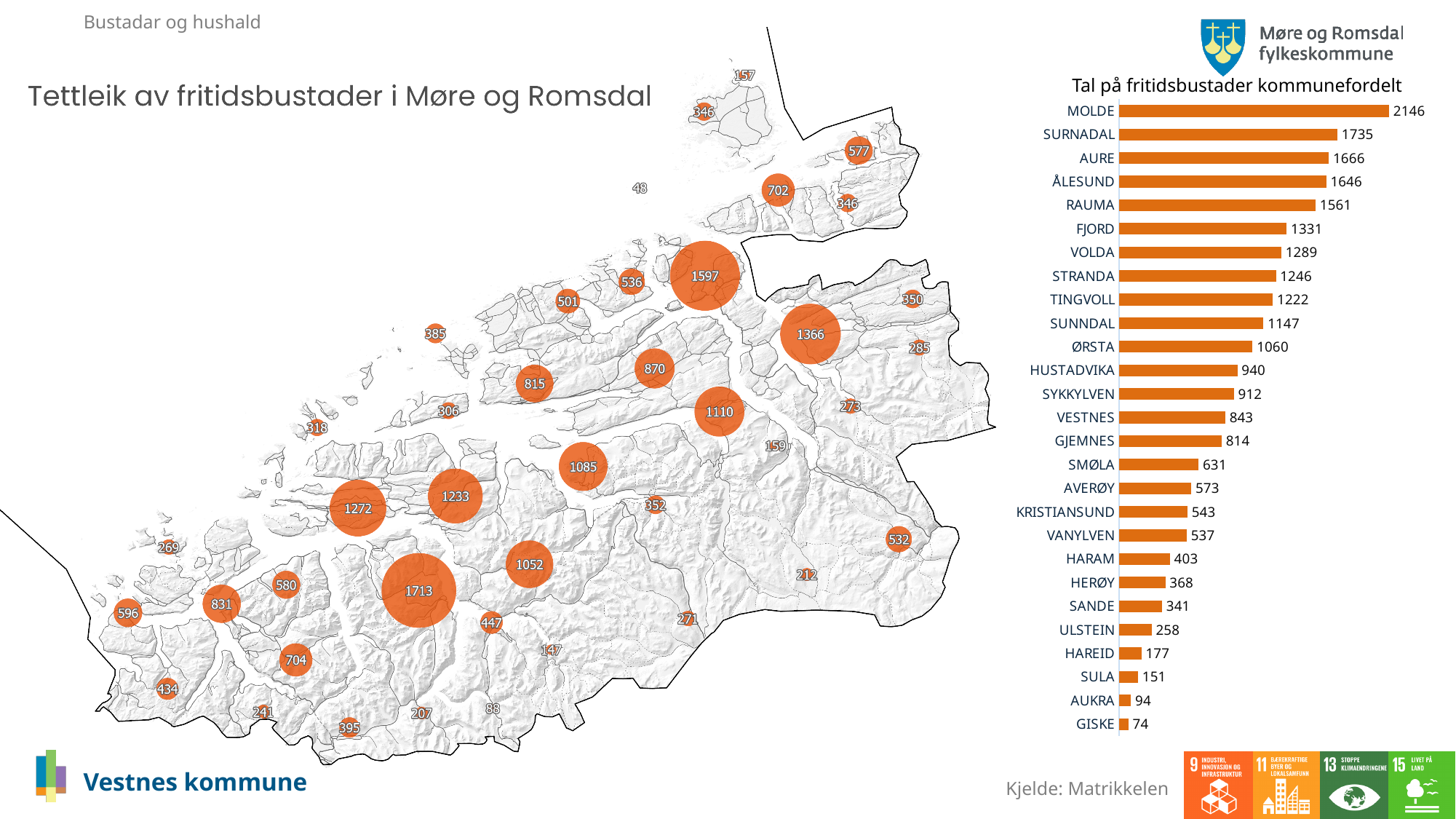
In the bar chart 'Tal på fritidsbustader kommunefordelt', what is the value for HAREID? 177 How many municipalities are listed in the bar chart 'Tal på fritidsbustader kommunefordelt'? 27 In the bar chart 'Tal på fritidsbustader kommunefordelt', which is larger, the value for VOLDA or the value for STRANDA? VOLDA In the bar chart 'Tal på fritidsbustader kommunefordelt', which is larger, the value for SMØLA or the value for HARAM? SMØLA What kind of chart is 'Tal på fritidsbustader kommunefordelt'? Bar chart In the bar chart 'Tal på fritidsbustader kommunefordelt', what is the value for RAUMA? 1561 In the bar chart 'Tal på fritidsbustader kommunefordelt', which municipality has the highest value? MOLDE In the bar chart 'Tal på fritidsbustader kommunefordelt', what is the difference between the values for MOLDE and SURNADAL? 411 In the bar chart 'Tal på fritidsbustader kommunefordelt', what is the difference between the values for VESTNES and GJEMNES? 29 In the bar chart 'Tal på fritidsbustader kommunefordelt', which municipality has the lowest value? GISKE What is the title of the bar chart on the right side of the slide? Tal på fritidsbustader kommunefordelt In the bar chart 'Tal på fritidsbustader kommunefordelt', what is the value for VESTNES? 843